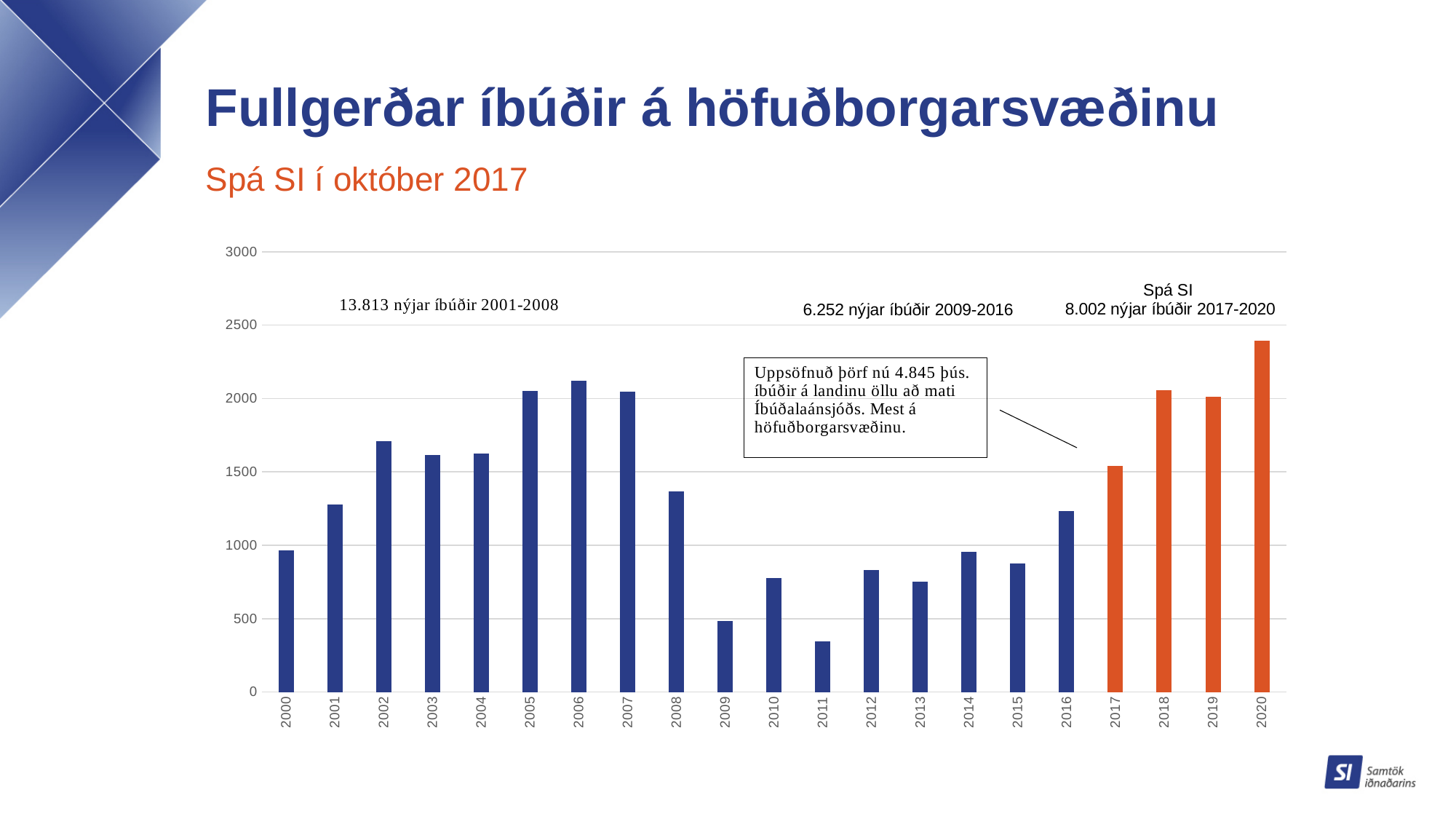
According to the annotation on the chart, how many new apartments were built in 2001-2008? 13.813 Which year has the larger value, 2002 or 2008? 2002 Is the value for 2016 greater or less than 1000? greater Is the value for 2006 greater or less than 2000? greater Do the values rise or fall from 2006 to 2009? Fall Which year has the larger value, 2010 or 2014? 2014 Which year has the lowest bar in the chart? 2011 What kind of chart is shown on the slide? Bar chart How many years are shown on the x axis of the chart? 21 Is the value for 2011 greater or less than 500? less Which year has the highest bar in the chart? 2020